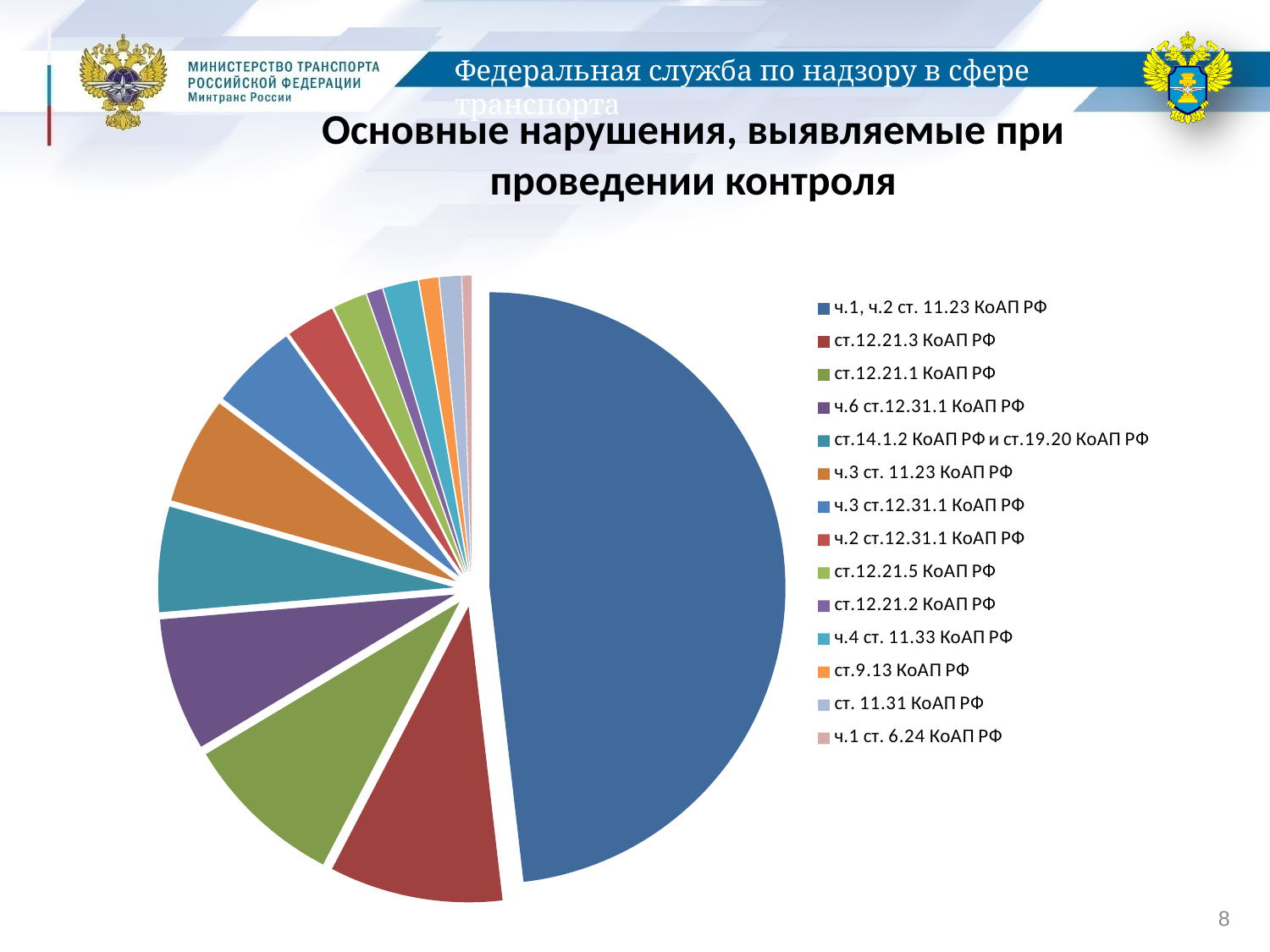
How many categories does the legend of the pie chart list? 14 What colour is the slice for ч.1, ч.2 ст. 11.23 КоАП РФ? blue Which category has the smallest slice of the pie chart? ч.1 ст. 6.24 КоАП РФ Which category has the largest slice of the pie chart? ч.1, ч.2 ст. 11.23 КоАП РФ What kind of chart is shown on the slide? pie chart What is the title of the chart on the slide? Основные нарушения, выявляемые при проведении контроля Which slice is larger: ст.14.1.2 КоАП РФ и ст.19.20 КоАП РФ or ст.9.13 КоАП РФ? ст.14.1.2 КоАП РФ и ст.19.20 КоАП РФ Which slice is larger: ч.6 ст.12.31.1 КоАП РФ or ч.3 ст.12.31.1 КоАП РФ? ч.6 ст.12.31.1 КоАП РФ Which slice is larger: ст.12.21.1 КоАП РФ or ст. 11.31 КоАП РФ? ст.12.21.1 КоАП РФ